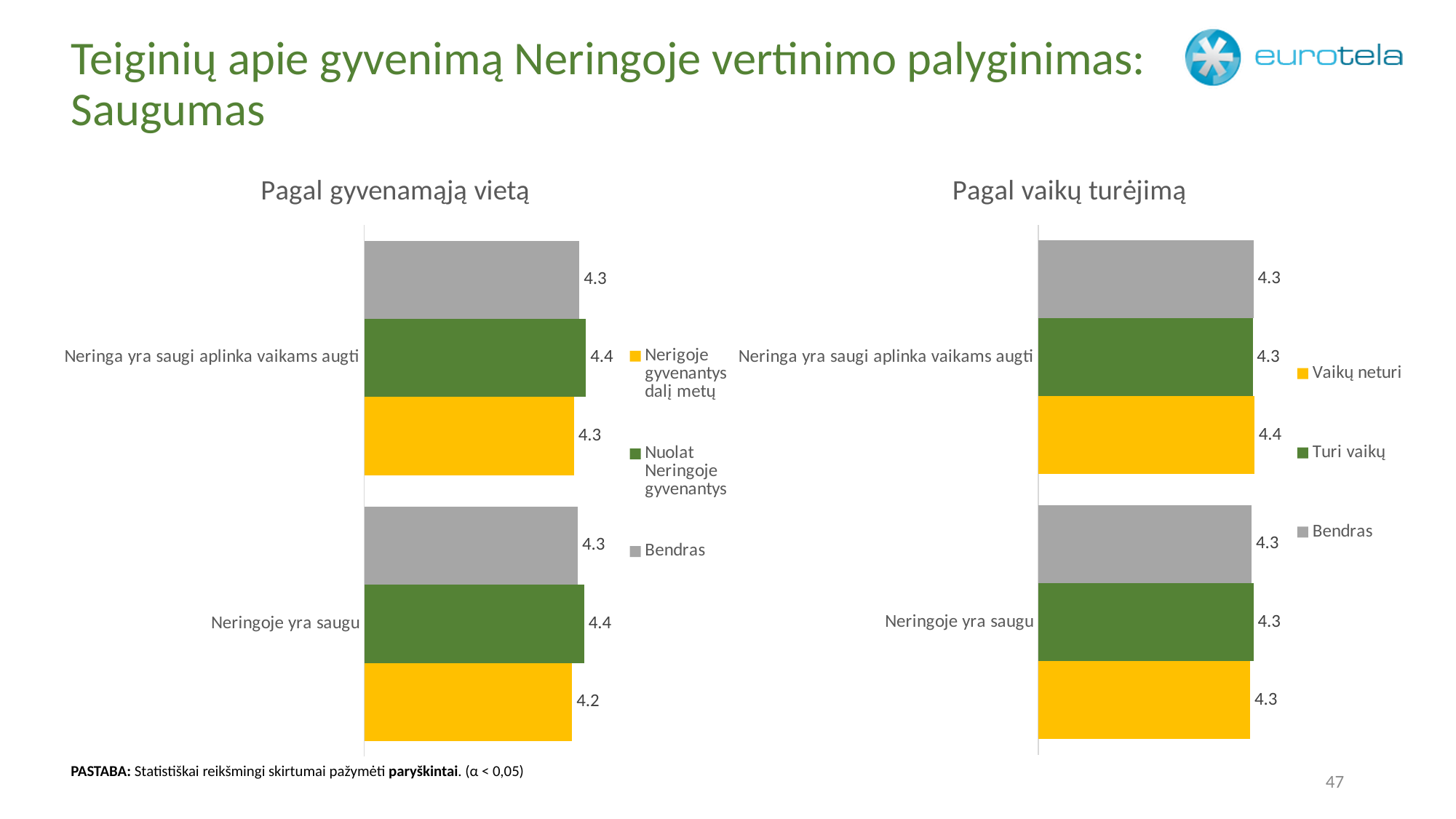
How many categories are shown in the chart titled "Pagal gyvenamąją vietą"? 2 In the chart titled "Pagal vaikų turėjimą", what is the value for "Turi vaikų" for "Neringoje yra saugu"? 4.3 In the chart titled "Pagal vaikų turėjimą", which series has the highest value for "Neringa yra saugi aplinka vaikams augti"? Vaikų neturi In the chart titled "Pagal vaikų turėjimą", what is the difference between the "Vaikų neturi" and "Bendras" values for "Neringa yra saugi aplinka vaikams augti"? 0.1 In the chart titled "Pagal gyvenamąją vietą", what is the value for "Nuolat Neringoje gyvenantys" for "Neringoje yra saugu"? 4.4 In the chart titled "Pagal gyvenamąją vietą", what is the value for "Bendras" for "Neringa yra saugi aplinka vaikams augti"? 4.3 In the chart titled "Pagal gyvenamąją vietą", what is the value for "Nerigoje gyvenantys dalį metų" for "Neringoje yra saugu"? 4.2 In the chart titled "Pagal gyvenamąją vietą", what is the difference between the "Nuolat Neringoje gyvenantys" and "Nerigoje gyvenantys dalį metų" values for "Neringoje yra saugu"? 0.2 What kind of chart is the chart titled "Pagal gyvenamąją vietą"? Bar chart In the chart titled "Pagal vaikų turėjimą", what is the value for "Vaikų neturi" for "Neringa yra saugi aplinka vaikams augti"? 4.4 How many series does the legend of the chart titled "Pagal vaikų turėjimą" list? 3 In the chart titled "Pagal gyvenamąją vietą", which series has the lowest value for "Neringoje yra saugu"? Nerigoje gyvenantys dalį metų